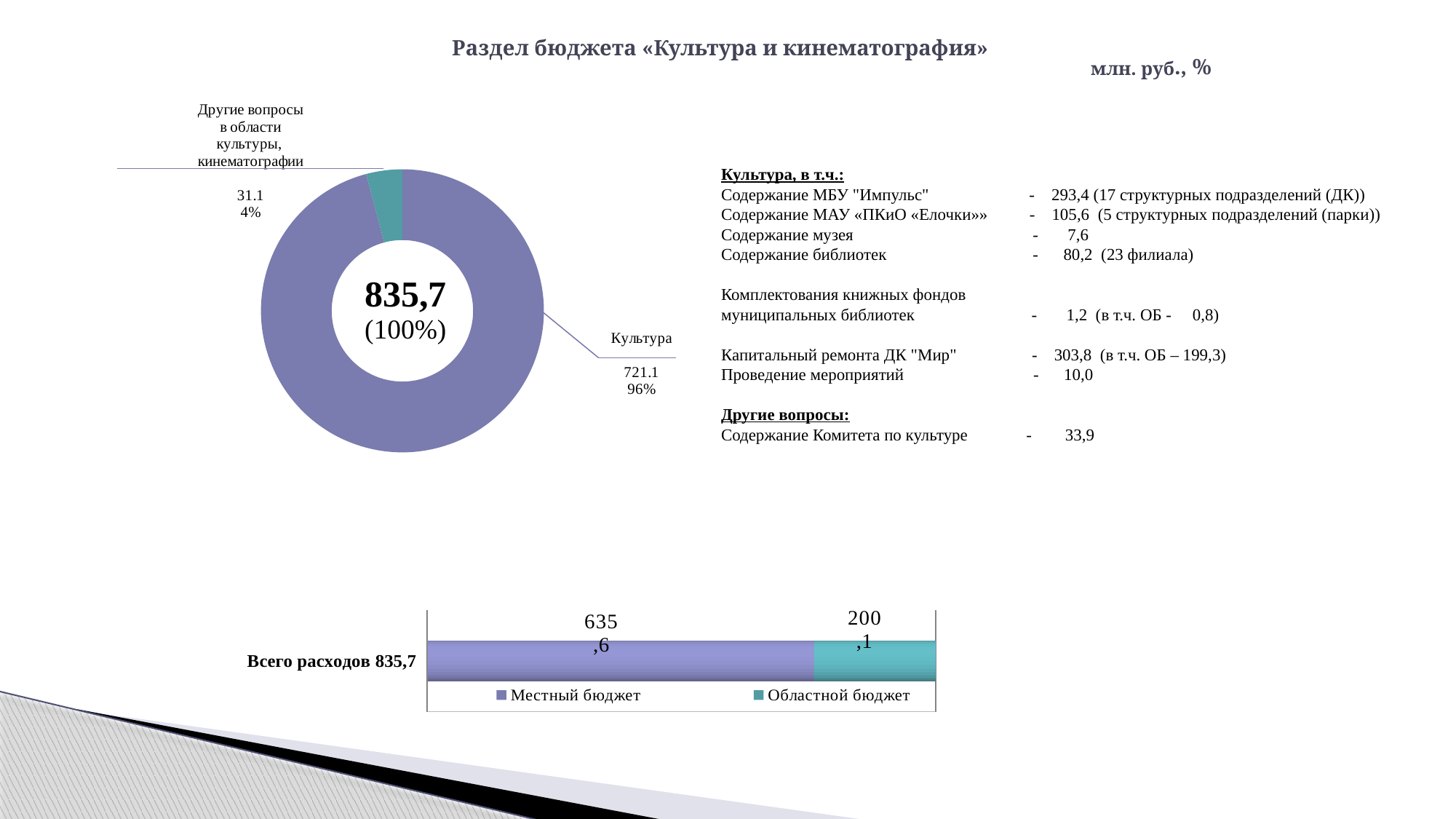
In the bottom bar chart, what is the value for «Областной бюджет»? 200,1 In the top-left pie chart, what value is shown for «Культура»? 721.1 In the top-left pie chart, what value is shown for «Другие вопросы в области культуры, кинематографии»? 31.1 In the top-left pie chart, what share does «Другие вопросы в области культуры, кинематографии» have? 4% In the top-left pie chart, what share of the total does «Культура» have? 96% In the bottom bar chart, what is the value for «Местный бюджет»? 635,6 How many slices does the top-left pie chart have? 2 What kind of chart is the chart at the top left of the slide? pie chart (doughnut) In the bottom bar chart, what is the difference between «Местный бюджет» and «Областной бюджет»? 435,5 In the top-left pie chart, which slice is the largest? Культура How many series does the legend of the bottom bar chart list? 2 What kind of chart is the chart at the bottom of the slide? bar chart